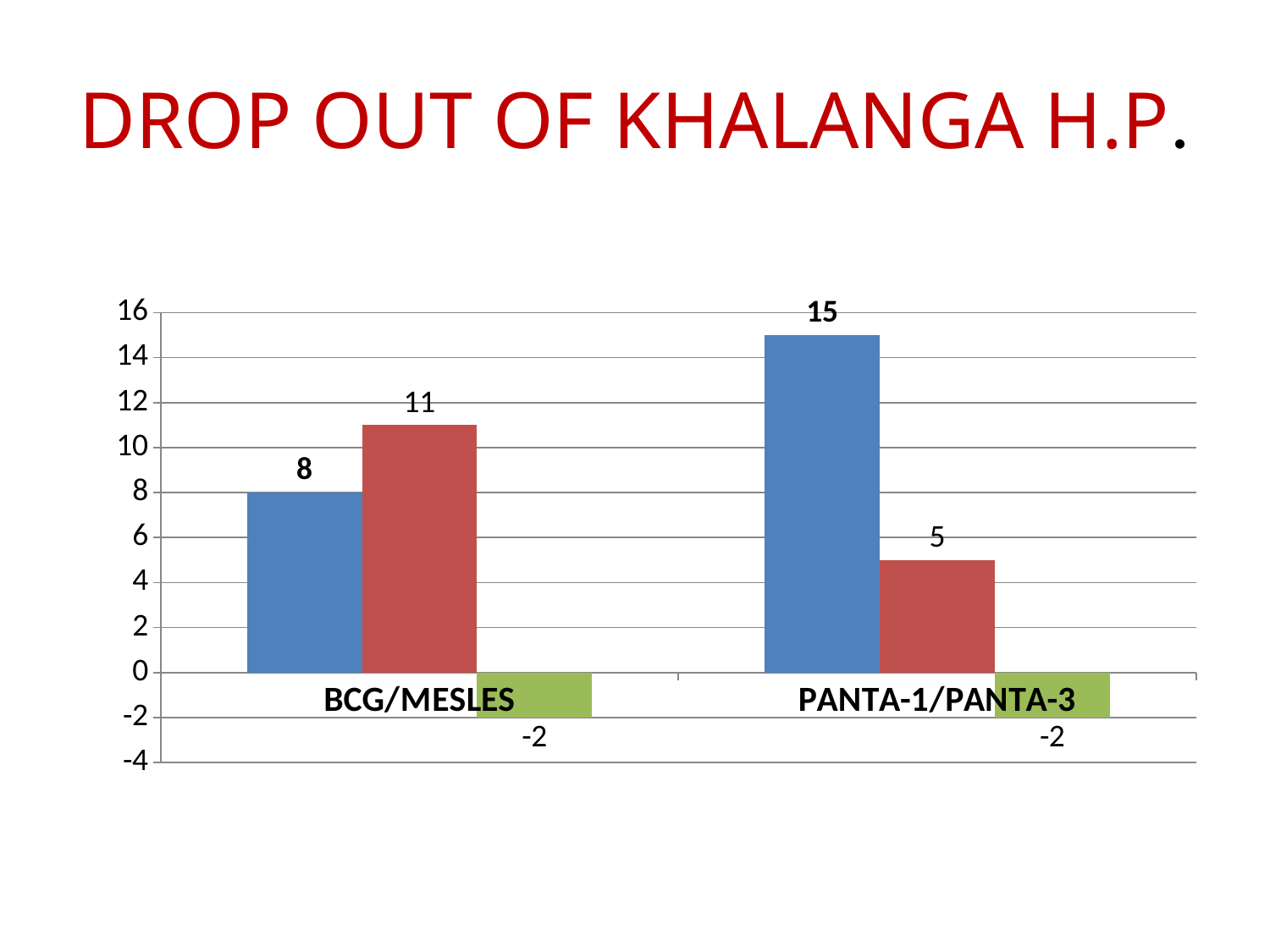
What is the value of the blue bar for BCG/MESLES? 8 What is the difference between the blue bar values for PANTA-1/PANTA-3 and BCG/MESLES? 7 How many categories are shown on the x axis? 2 How many bars are shown for each category? 3 What kind of chart is shown on the slide? Bar chart Which bar has the highest value on the chart? The blue bar for PANTA-1/PANTA-3 (15) What is the value of the red bar for BCG/MESLES? 11 Which is larger for PANTA-1/PANTA-3, the blue bar or the red bar? The blue bar What is the title of the slide? DROP OUT OF KHALANGA H.P. What is the difference between the red bar and the blue bar for BCG/MESLES? 3 What is the value of the red bar for PANTA-1/PANTA-3? 5 What is the value of the green bar for BCG/MESLES? -2